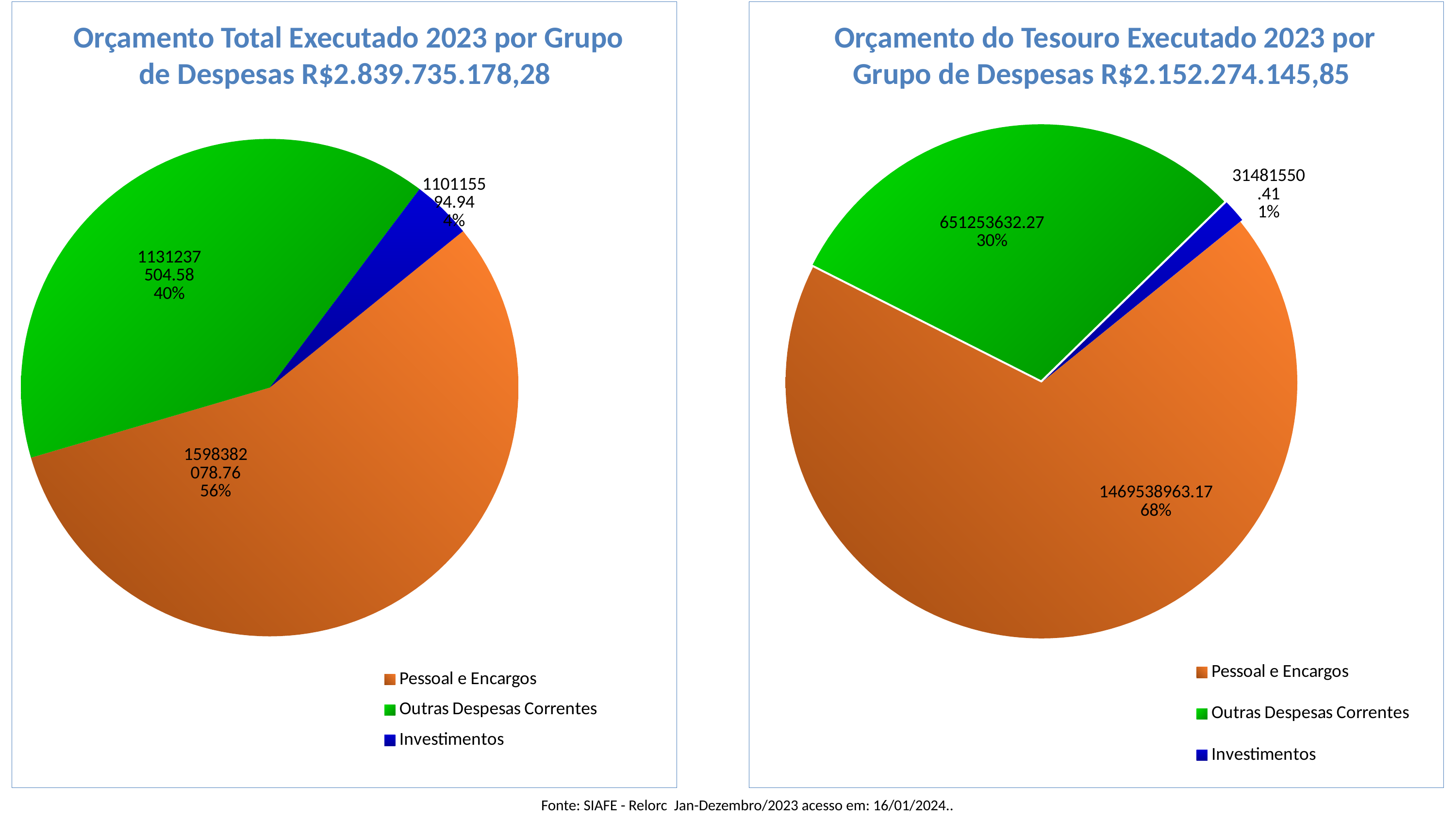
In the right chart (Orçamento do Tesouro Executado 2023), what share of the pie is Pessoal e Encargos? 68% In the right chart (Orçamento do Tesouro Executado 2023), what is the value shown for Outras Despesas Correntes? 651253632.27 In the left chart (Orçamento Total Executado 2023), which category has the largest slice? Pessoal e Encargos In the left chart (Orçamento Total Executado 2023), what share of the pie is Outras Despesas Correntes? 40% In the right chart (Orçamento do Tesouro Executado 2023), which category has the smallest slice? Investimentos In the left chart (Orçamento Total Executado 2023), how many percentage points larger is the Pessoal e Encargos share than the Outras Despesas Correntes share? 16 percentage points In the left chart (Orçamento Total Executado 2023), what is the value shown for Investimentos? 110115594.94 In the left chart (Orçamento Total Executado 2023), what share of the pie is Pessoal e Encargos? 56% What total amount is stated in the title of the right chart (Orçamento do Tesouro Executado 2023)? R$2.152.274.145,85 In the left chart (Orçamento Total Executado 2023), what is the value shown for Pessoal e Encargos? 1598382078.76 In the right chart (Orçamento do Tesouro Executado 2023), how many slices does the pie have? 3 What type of chart is the left chart (Orçamento Total Executado 2023)? Pie chart